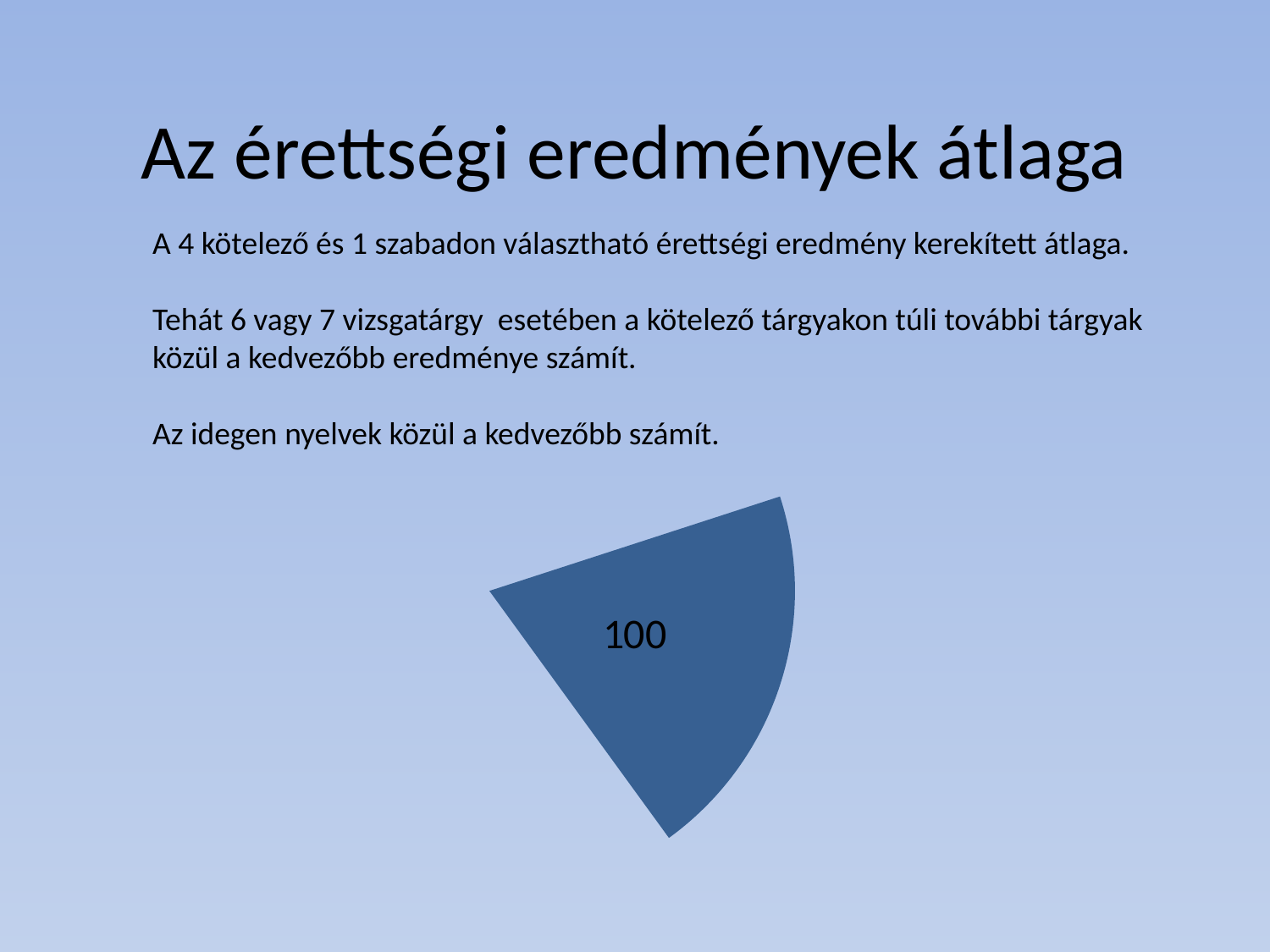
What value is printed on the visible slice of the pie chart? 100 Does the pie chart display a legend? No What colour is the visible slice of the pie chart? blue How many slices are visibly drawn on the pie chart? 1 What kind of chart is shown on the slide? pie chart How many data labels are printed on the pie chart? 1